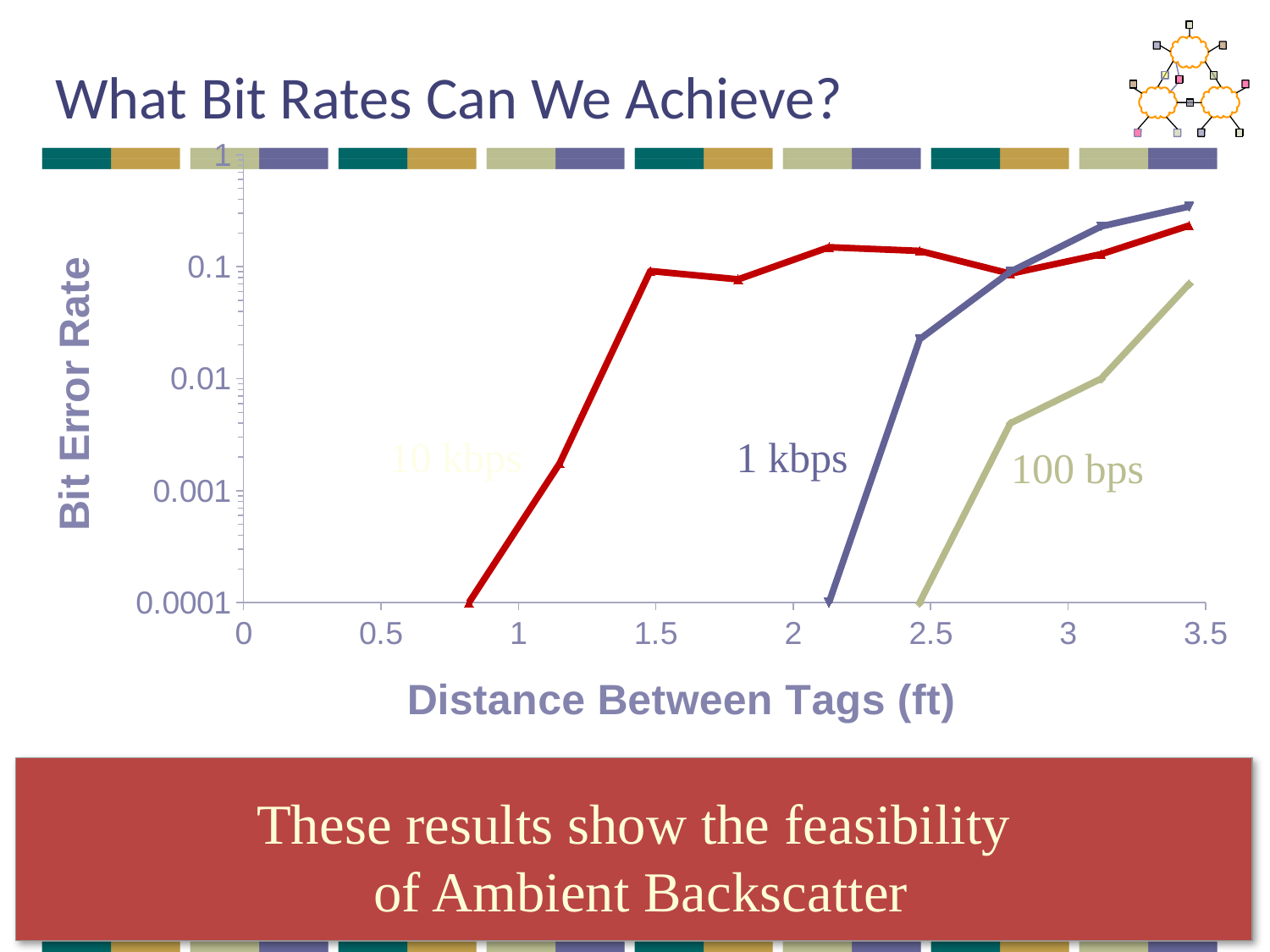
As the distance between tags increases, does the bit error rate for each series rise or fall? rise How many data series (bit rates) are labelled on the chart? 3 Which series has the lowest bit error rate at 3.5 ft? 100 bps Is the bit error rate for 10 kbps at 1.5 ft greater or less than 0.01? greater At 3 ft, which series has the higher bit error rate, 10 kbps or 100 bps? 10 kbps Is the bit error rate for 100 bps at 3 ft greater or less than 0.1? less How many tick labels are shown on the x-axis? 8 Is the bit error rate for 1 kbps at 2.5 ft greater or less than 0.01? greater What is the label of the x-axis? Distance Between Tags (ft) What kind of chart is shown on the slide? line chart What is the label of the y-axis? Bit Error Rate At 2.5 ft, which series has the higher bit error rate, 10 kbps or 1 kbps? 10 kbps